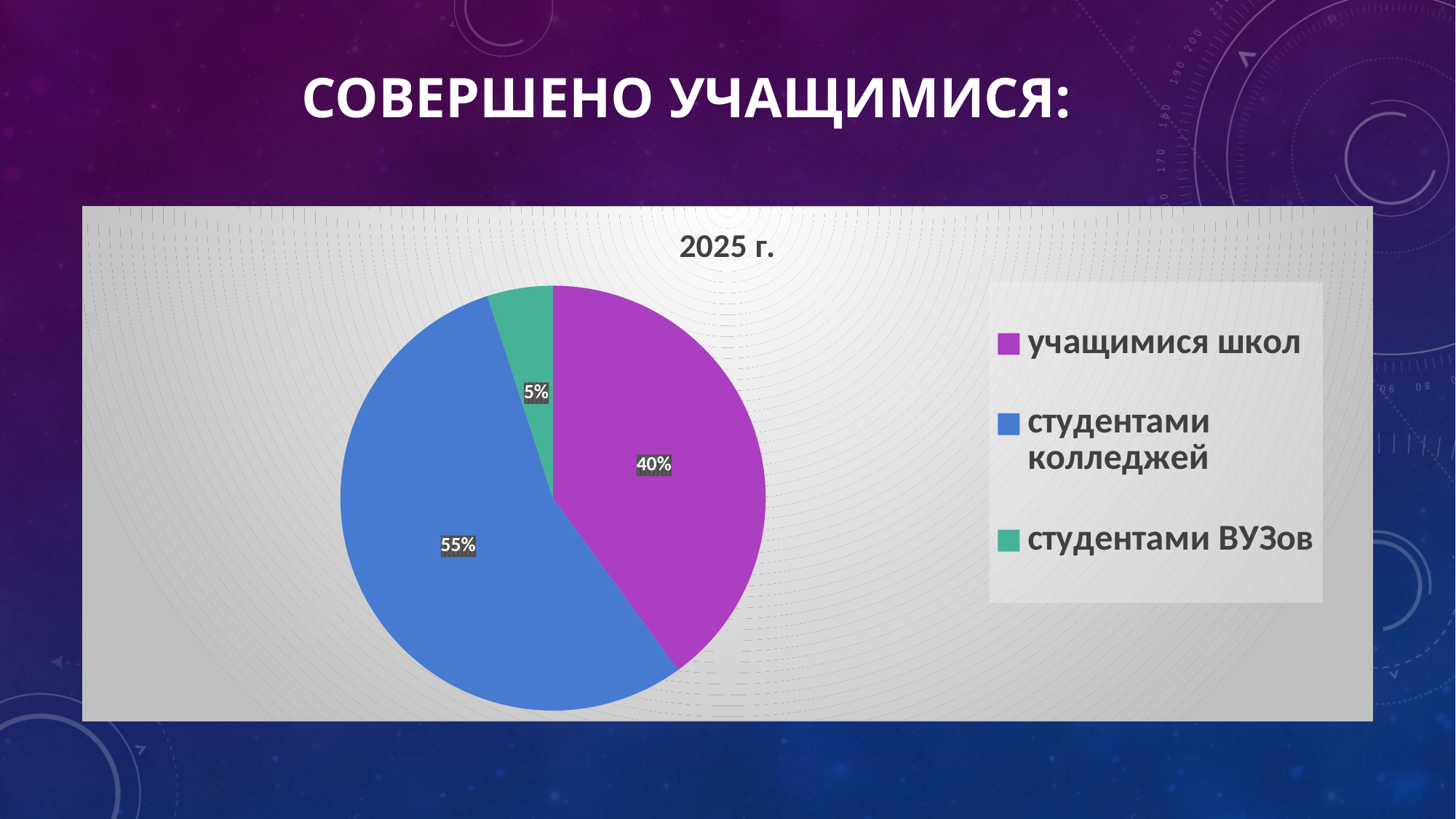
What share of the pie is labelled for учащимися школ? 40% What share of the pie is labelled for студентами ВУЗов? 5% What is the difference in percentage points between студентами колледжей and учащимися школ? 15% What kind of chart is shown on the slide? pie chart Which is larger: the slice for учащимися школ or the slice for студентами ВУЗов? учащимися школ Which category has the largest slice of the pie? студентами колледжей What is the difference in percentage points between учащимися школ and студентами ВУЗов? 35% What share of the pie is labelled for студентами колледжей? 55% What colour is the slice for студентами колледжей? blue What is the chart's title? 2025 г. How many categories does the legend list? 3 Which category has the smallest slice of the pie? студентами ВУЗов